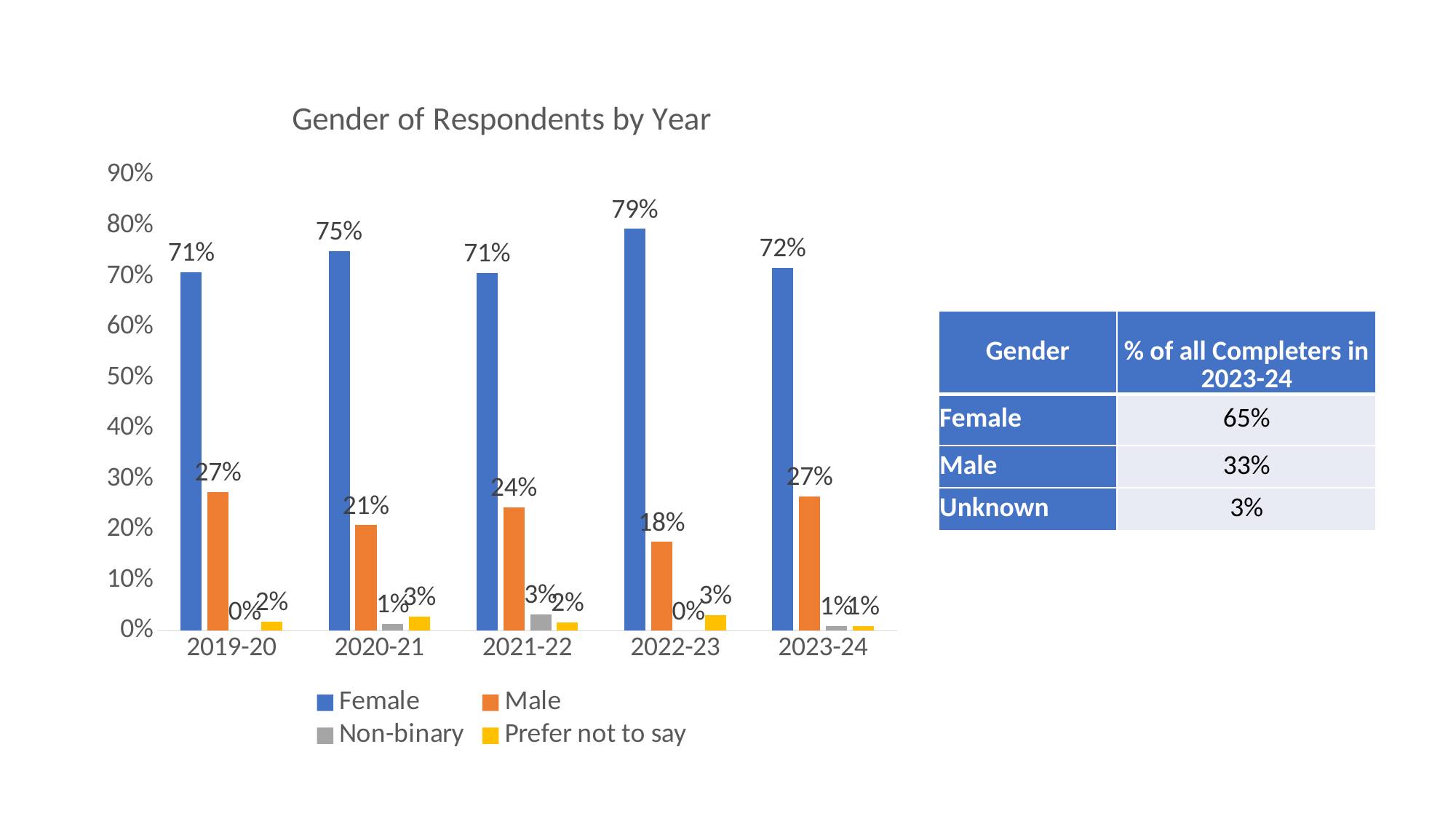
How many years are shown on the x axis of the Gender of Respondents by Year chart? 5 In which year is the Male value lowest in the Gender of Respondents by Year chart? 2022-23 What is the Male value for 2020-21 in the Gender of Respondents by Year chart? 21% What is the Prefer not to say value for 2022-23 in the Gender of Respondents by Year chart? 3% Is the Female value for 2020-21 greater or less than 70% in the Gender of Respondents by Year chart? greater Which series is shown in orange in the Gender of Respondents by Year chart? Male What kind of chart is the Gender of Respondents by Year chart? bar chart What is the Female value for 2022-23 in the Gender of Respondents by Year chart? 79% How many series does the legend of the Gender of Respondents by Year chart list? 4 In which year is the Female value highest in the Gender of Respondents by Year chart? 2022-23 What is the difference between the Female and Male values for 2023-24 in the Gender of Respondents by Year chart? 45% Which is larger in the Gender of Respondents by Year chart: the Male value for 2019-20 or the Male value for 2021-22? Male value for 2019-20